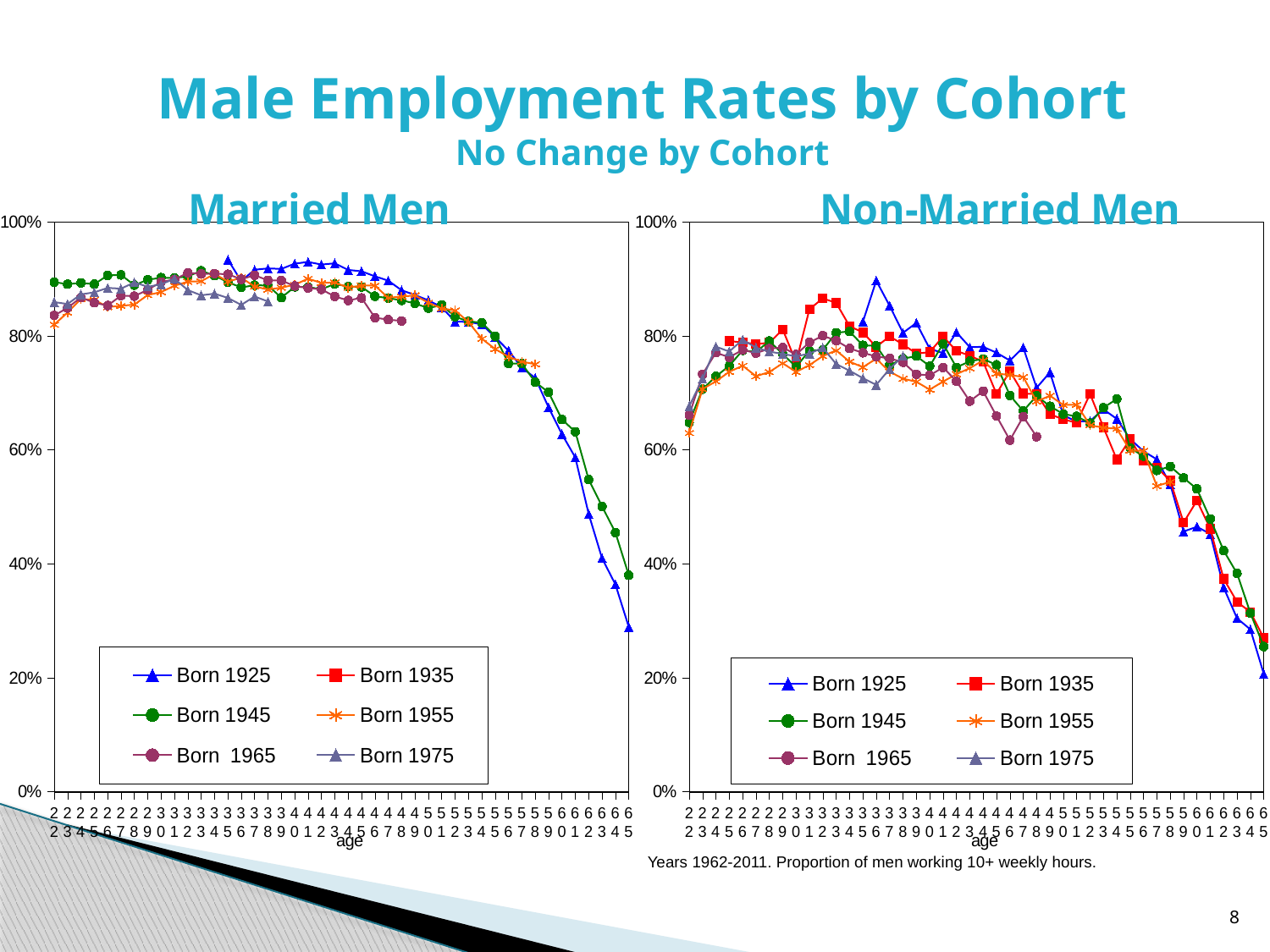
How many series does the legend of the Non-Married Men chart list? 6 In the Non-Married Men chart, is the value for Born 1925 at age 65 greater or less than 40%? less In the Married Men chart, is the value for Born 1945 at age 65 greater or less than 60%? less In the Married Men chart, is the value for Born 1925 at age 65 greater or less than 40%? less In the Married Men chart, do the values for Born 1925 rise or fall between age 55 and age 65? fall In the Non-Married Men chart, do the values for Born 1945 rise or fall between age 55 and age 65? fall What is the x-axis label on the Married Men chart? age In the Married Men chart, which is larger at age 65: the value for Born 1925 or the value for Born 1945? Born 1945 What kind of chart is the Married Men chart? line chart What is the title of the chart on the right side of the slide? Non-Married Men In the Non-Married Men chart, which series has the lowest value at age 65? Born 1925